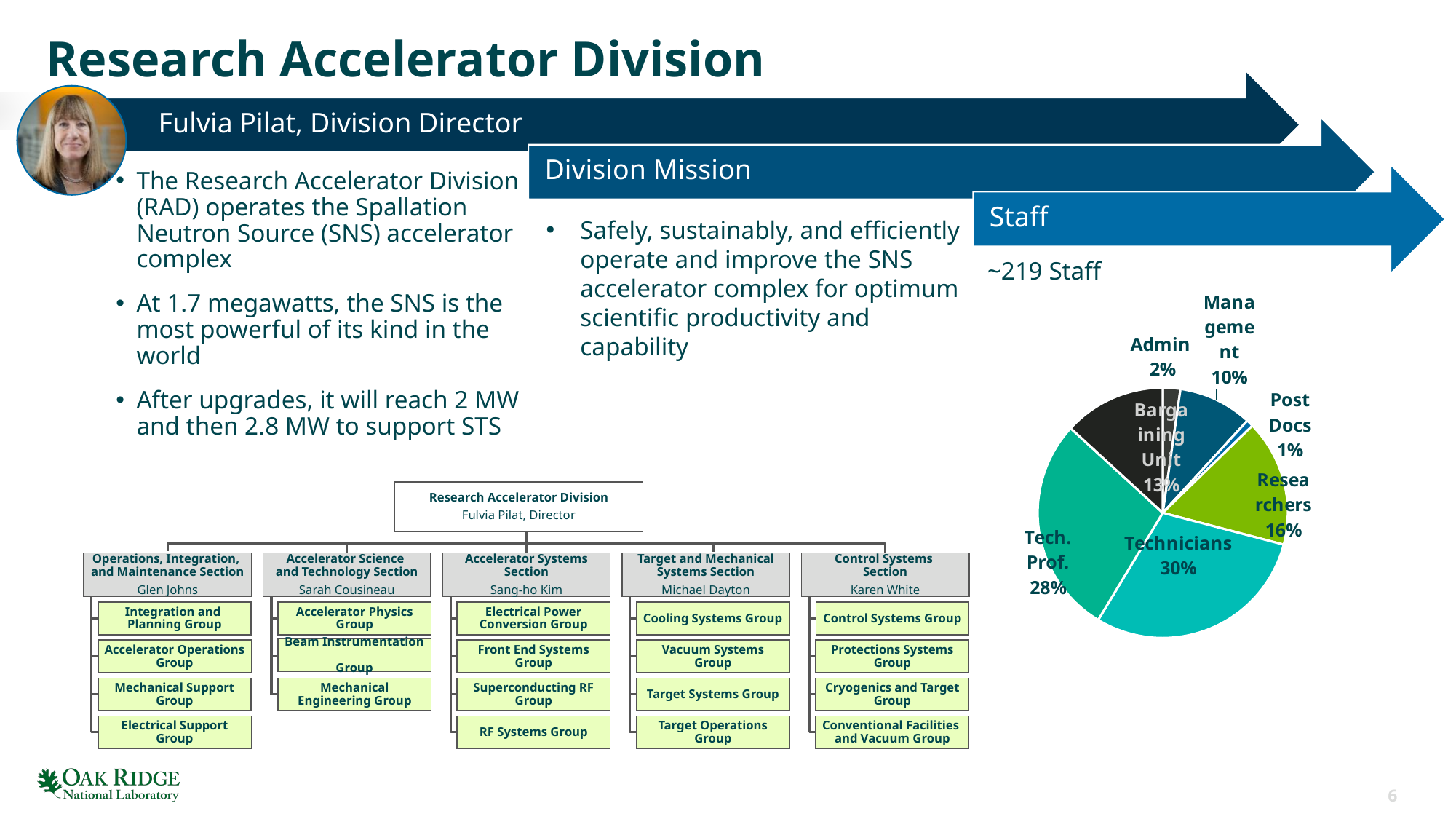
In the staff pie chart, what is the difference in percentage points between Technicians and Tech. Prof.? 2 In the staff pie chart, what share of staff are Post Docs? 1% In the staff pie chart, what share of staff are Researchers? 16% What approximate total staff count is stated above the staff pie chart? ~219 Staff In the staff pie chart, what share of staff are in the Bargaining Unit? 13% What kind of chart is shown under the Staff heading? pie chart In the staff pie chart, what share of staff are Technicians? 30% In the staff pie chart, which is larger: Researchers or Bargaining Unit? Researchers How many categories are shown in the staff pie chart? 7 In the staff pie chart, what share of staff are Management? 10% Which category has the largest slice in the staff pie chart? Technicians Which category has the smallest slice in the staff pie chart? Post Docs